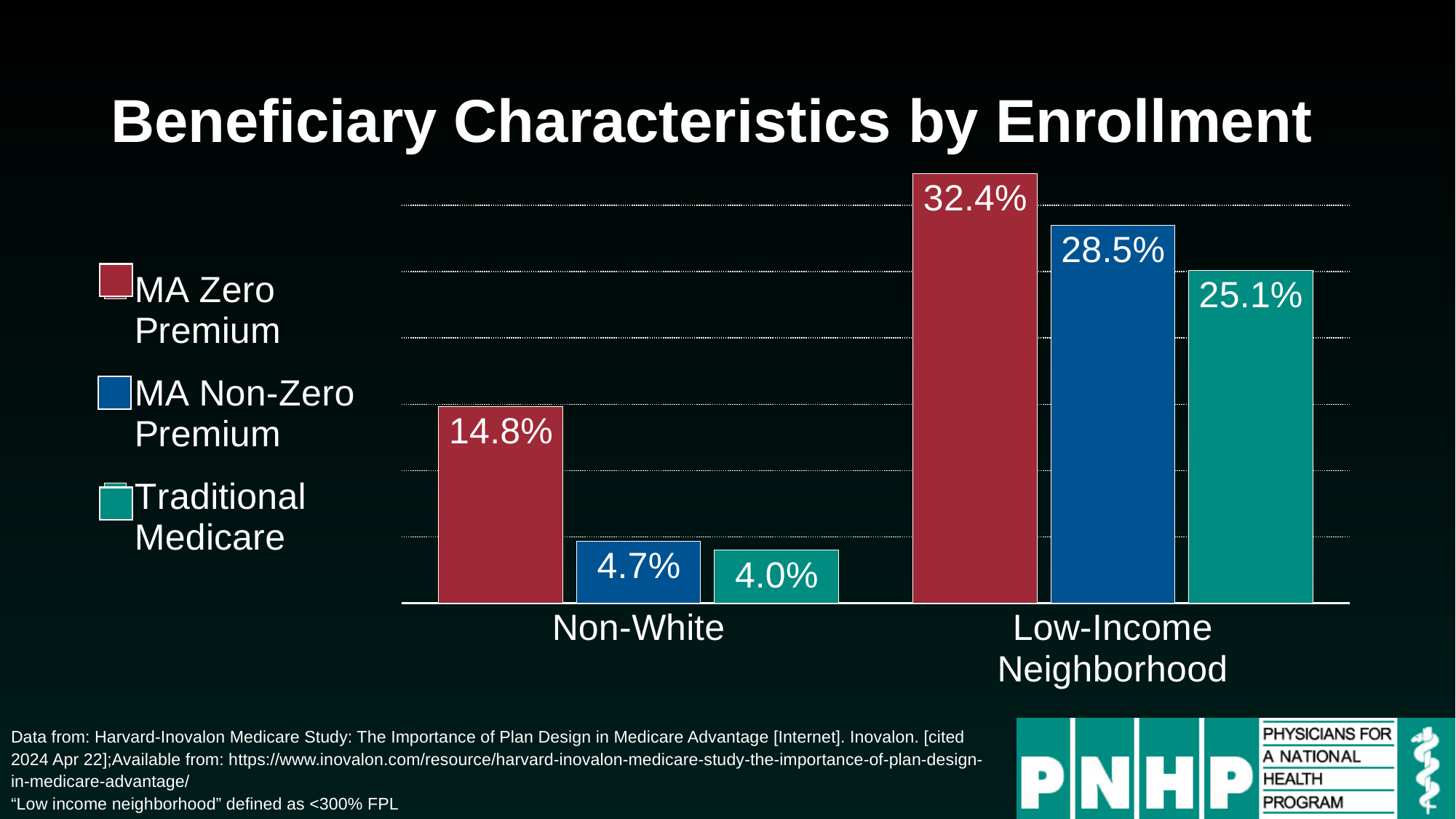
How many series does the legend list? 3 Which is larger: MA Non-Zero Premium for Non-White or Traditional Medicare for Non-White? MA Non-Zero Premium for Non-White Which series has the highest value in the Low-Income Neighborhood category? MA Zero Premium What kind of chart is shown on the slide? Bar chart What is the value for Traditional Medicare in the Low-Income Neighborhood category? 25.1% What is the difference between MA Zero Premium and Traditional Medicare in the Non-White category? 10.8% What is the title of the chart? Beneficiary Characteristics by Enrollment What is the difference between MA Zero Premium and MA Non-Zero Premium in the Low-Income Neighborhood category? 3.9% What is the value for MA Non-Zero Premium in the Non-White category? 4.7% Which series has the lowest value in the Non-White category? Traditional Medicare How many categories are shown on the x axis? 2 What is the value for MA Zero Premium in the Non-White category? 14.8%